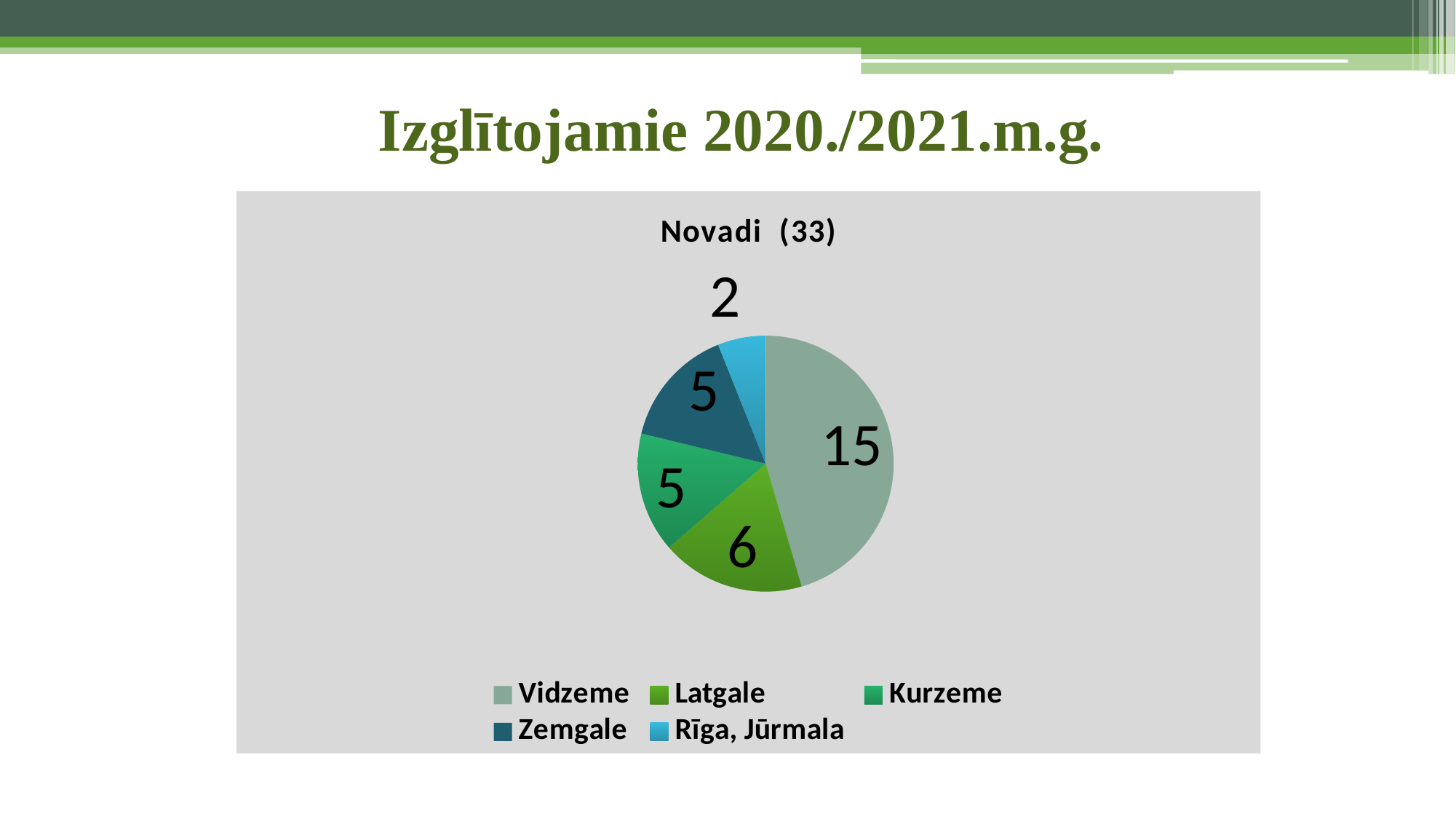
What is the value for Vidzeme in the Novadi (33) pie chart? 15 What is the value for Rīga, Jūrmala in the pie chart? 2 Which category has the largest slice in the pie chart? Vidzeme Which is larger, the value for Latgale or the value for Zemgale? Latgale Which category has the smallest slice in the pie chart? Rīga, Jūrmala What is the value for Zemgale in the pie chart? 5 What is the value for Latgale in the pie chart? 6 What kind of chart is shown on the slide? Pie chart What is the title of the chart? Novadi (33) How many categories does the pie chart show? 5 What is the difference between the values for Kurzeme and Rīga, Jūrmala? 3 What is the difference between the values for Vidzeme and Latgale? 9